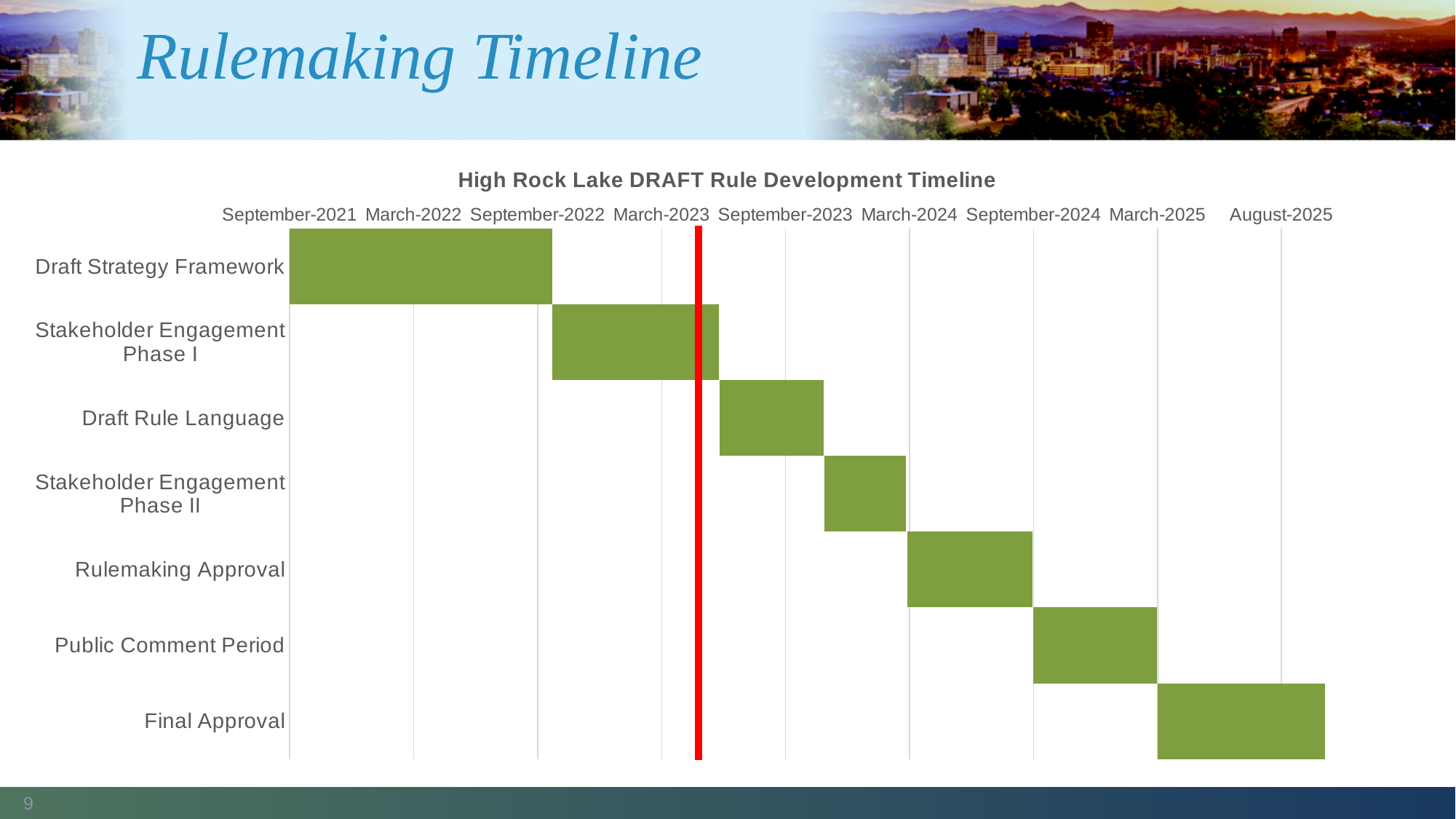
What kind of chart is shown on the slide? Bar chart (Gantt chart) Which bar is longer, Draft Strategy Framework or Final Approval? Draft Strategy Framework How many tasks (categories) are listed on the chart? 7 What is the first axis label shown on the timeline axis? September-2021 Which task has the longest bar on the chart? Draft Strategy Framework What is the title of the chart? High Rock Lake DRAFT Rule Development Timeline At which axis label does the Draft Strategy Framework bar begin? September-2021 Which task's bar runs from September-2024 to March-2025? Public Comment Period Which task is scheduled last on the timeline? Final Approval Between which two axis labels does the red vertical line fall? March-2023 and September-2023 Which task comes immediately after Draft Rule Language on the timeline? Stakeholder Engagement Phase II Which task is scheduled first on the timeline? Draft Strategy Framework